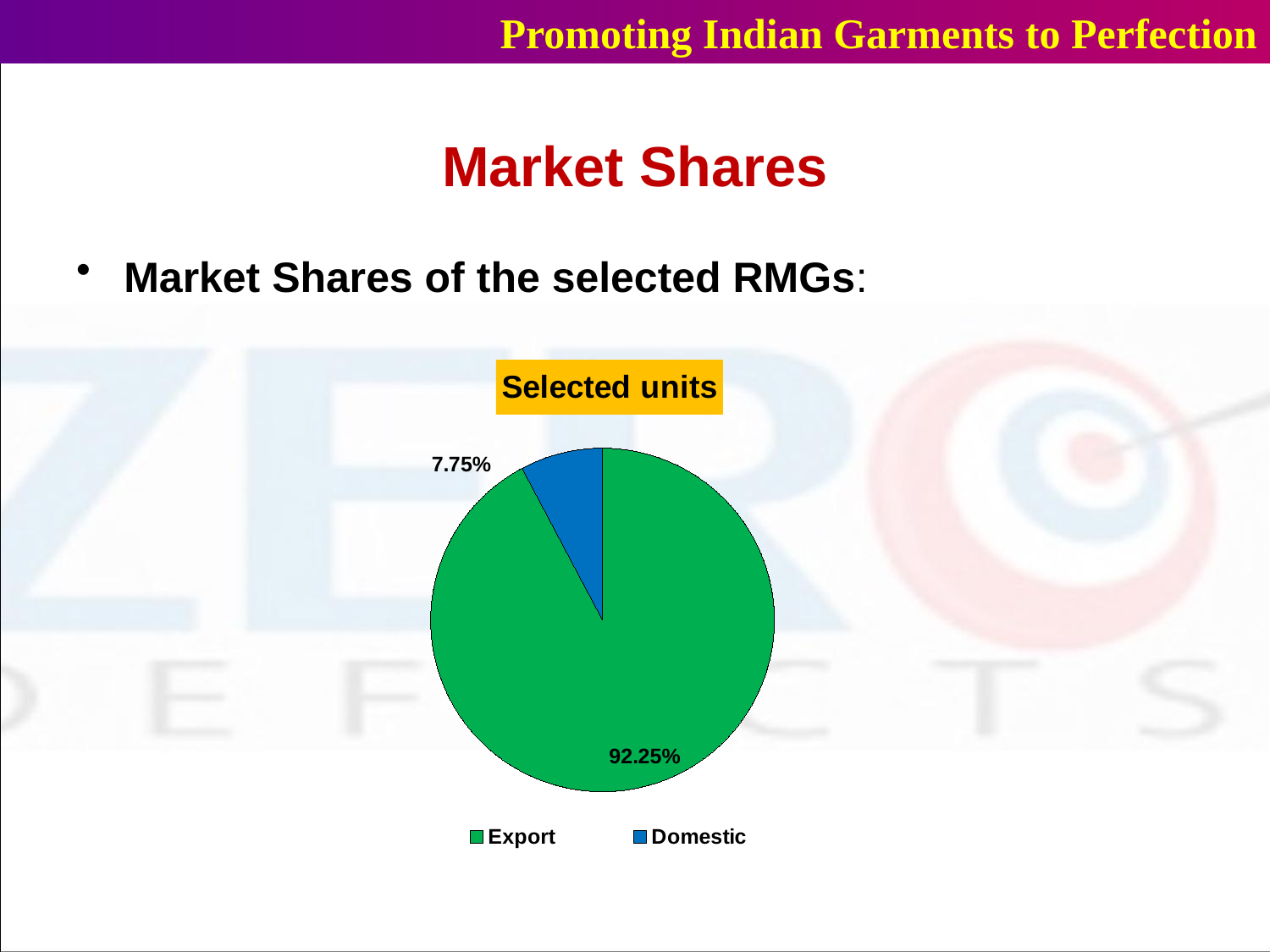
How many entries does the legend list? 2 What share of the pie does Domestic have? 7.75% Which is larger, the Export share or the Domestic share? Export Which slice is the smallest? Domestic How many slices does the pie chart have? 2 What share of the pie does Export have? 92.25% Which slice is the largest? Export What is the difference between the Export share and the Domestic share? 84.5% What is the title of the chart? Selected units What kind of chart is shown on the slide? Pie chart What colour is the Domestic slice? Blue